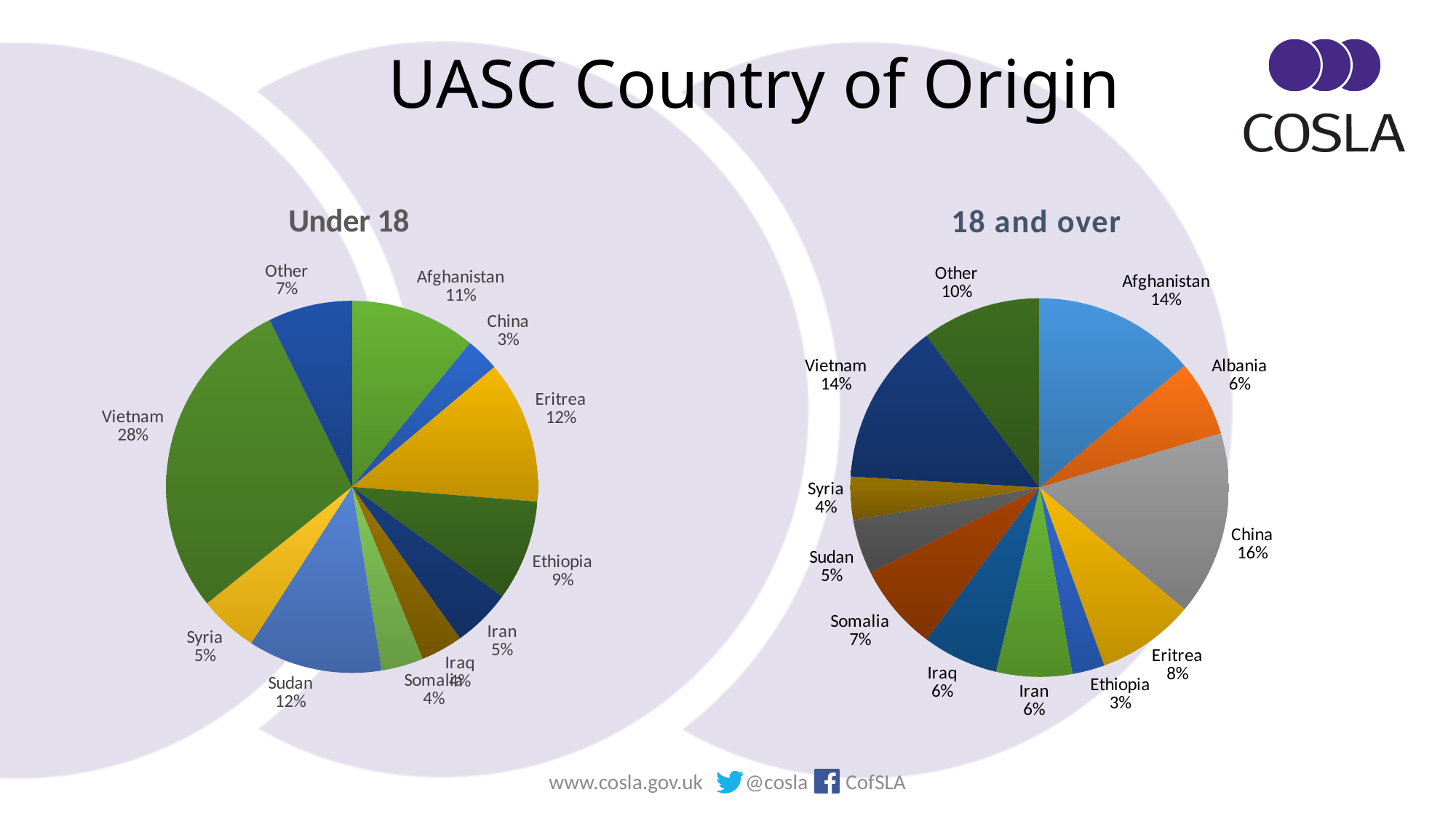
In the 18 and over pie chart, what share does China have? 16% What type of chart is used for the Under 18 data? Pie chart How many slices does the 18 and over pie chart have? 12 In the 18 and over pie chart, which is larger, the share for Afghanistan or the share for Eritrea? Afghanistan In the Under 18 pie chart, which country has the largest share? Vietnam In the Under 18 pie chart, what is the difference in percentage points between Vietnam and Eritrea? 16 In the Under 18 pie chart, which country has the smallest share? China In the 18 and over pie chart, which country has the smallest share? Ethiopia In the Under 18 pie chart, what share does Sudan have? 12% In the 18 and over pie chart, what share does Albania have? 6% In the 18 and over pie chart, which country has the largest share? China